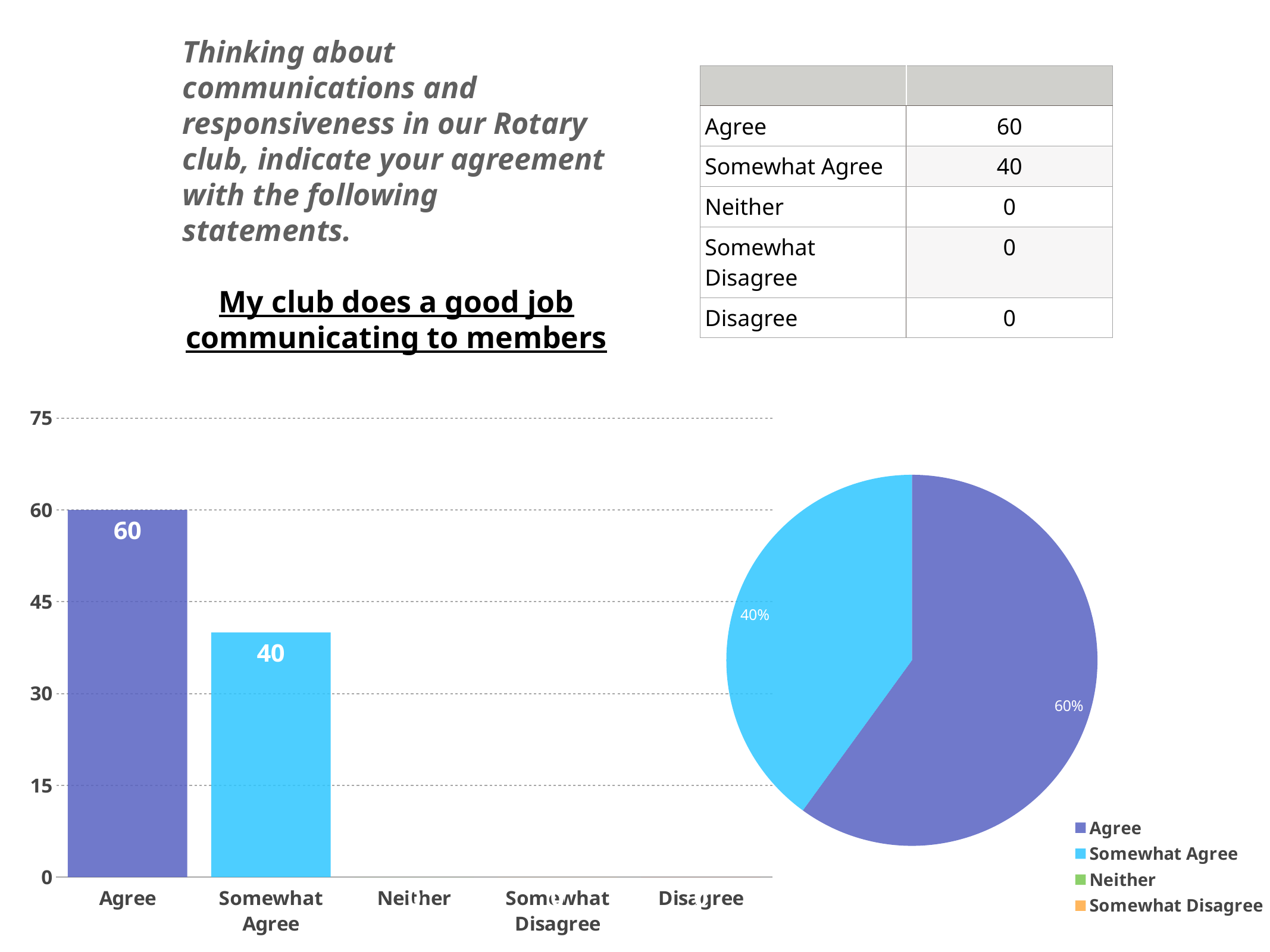
In the bar chart, what is the value for Somewhat Agree? 40 In the bar chart, what is the difference between the values for Agree and Somewhat Agree? 20 In the bar chart, which is larger, the value for Agree or the value for Somewhat Agree? Agree In the pie chart, what share does the Agree slice have? 60% How many entries does the legend of the pie chart list? 4 In the bar chart, what is the value for Agree? 60 In the bar chart, is the value for Somewhat Agree greater or less than 45? less What kind of chart is the chart on the left of the slide? bar chart In the bar chart, which category has the highest value? Agree In the pie chart, what share does the Somewhat Agree slice have? 40% What kind of chart is the chart on the right of the slide? pie chart How many categories are shown on the x axis of the bar chart? 5